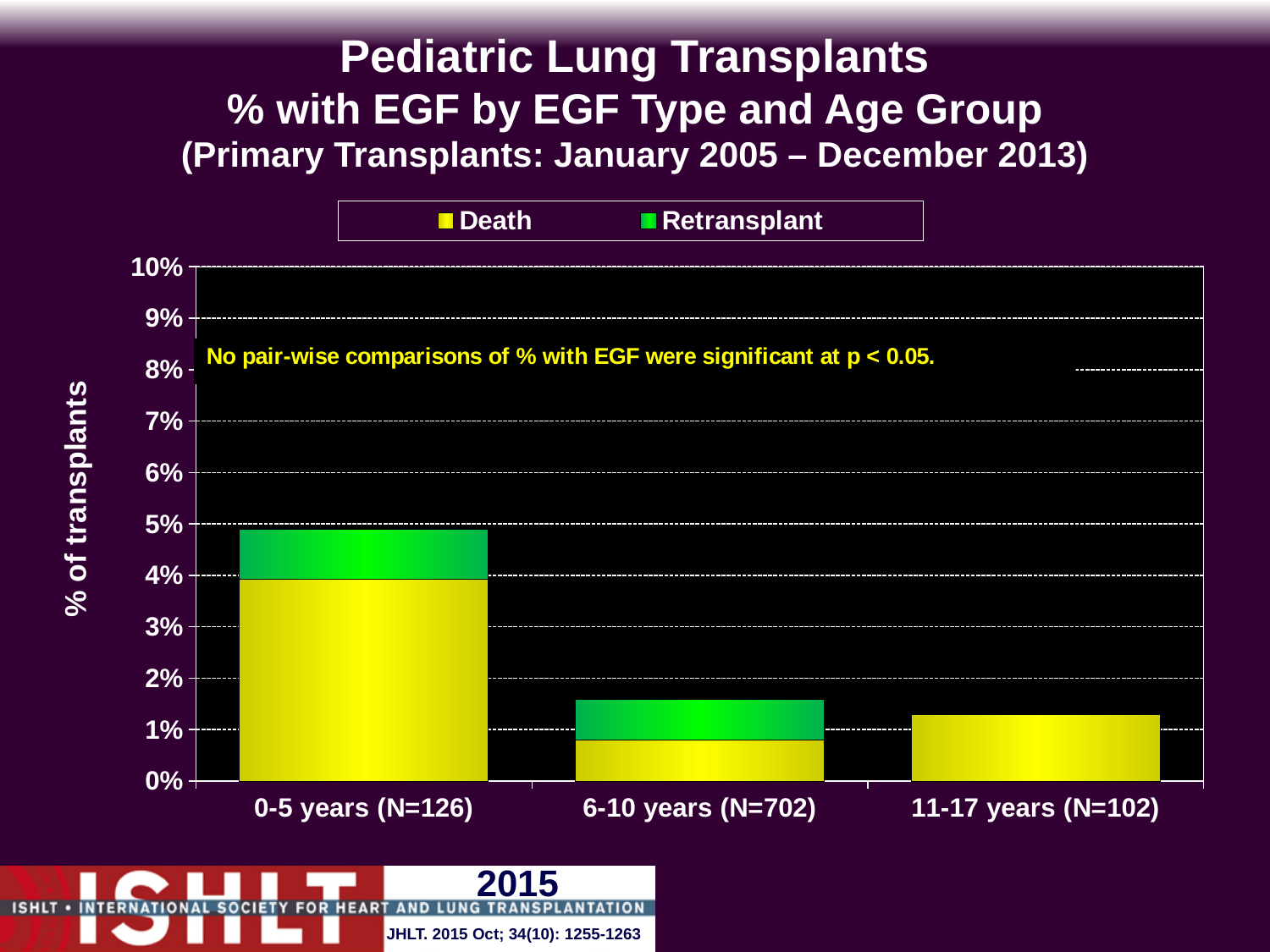
What kind of chart is shown on the slide? bar chart What is the label on the y axis? % of transplants How many series does the legend list? 2 Which is larger, the Death value for 0-5 years (N=126) or for 11-17 years (N=102)? 0-5 years (N=126) Which age group has the lowest Death value? 6-10 years (N=702) What are the two series named in the legend? Death and Retransplant How many age groups are shown on the x axis? 3 Is the total % with EGF for 0-5 years (N=126) greater or less than 4%? greater Is the Death value for 6-10 years (N=702) greater or less than 1%? less Which age group has the highest total % with EGF? 0-5 years (N=126) Is the Death value for 0-5 years (N=126) greater or less than 3%? greater